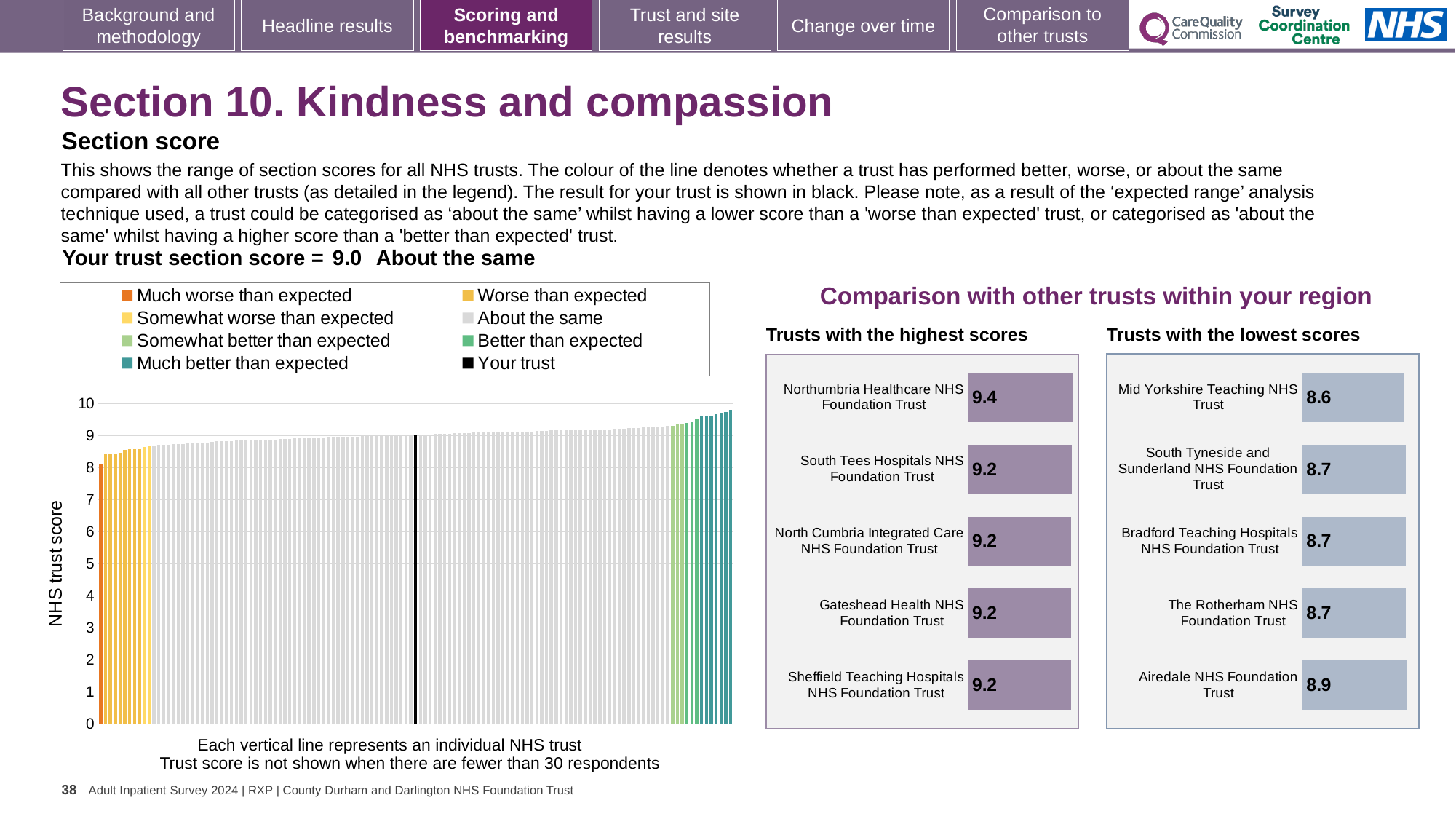
How many trusts are shown in the 'Trusts with the highest scores' chart? 5 In the 'Trusts with the highest scores' chart, which trust has the highest score? Northumbria Healthcare NHS Foundation Trust In the 'Trusts with the lowest scores' chart, what is the score for Mid Yorkshire Teaching NHS Trust? 8.6 What kind of chart is the large 'NHS trust score' chart on the left of the slide? Bar chart How many entries does the legend of the 'NHS trust score' chart list? 8 In the 'Trusts with the lowest scores' chart, which has the larger score: Airedale NHS Foundation Trust or Bradford Teaching Hospitals NHS Foundation Trust? Airedale NHS Foundation Trust In the 'Trusts with the lowest scores' chart, what is the difference between the scores of Airedale NHS Foundation Trust and Mid Yorkshire Teaching NHS Trust? 0.3 In the 'Trusts with the highest scores' chart, what is the score for Northumbria Healthcare NHS Foundation Trust? 9.4 In the 'NHS trust score' chart, what is the section score for your trust (the black bar)? 9.0 In the 'Trusts with the lowest scores' chart, which trust has the highest score? Airedale NHS Foundation Trust In the 'Trusts with the highest scores' chart, what is the score for Sheffield Teaching Hospitals NHS Foundation Trust? 9.2 In the 'Trusts with the lowest scores' chart, which trust has the lowest score? Mid Yorkshire Teaching NHS Trust